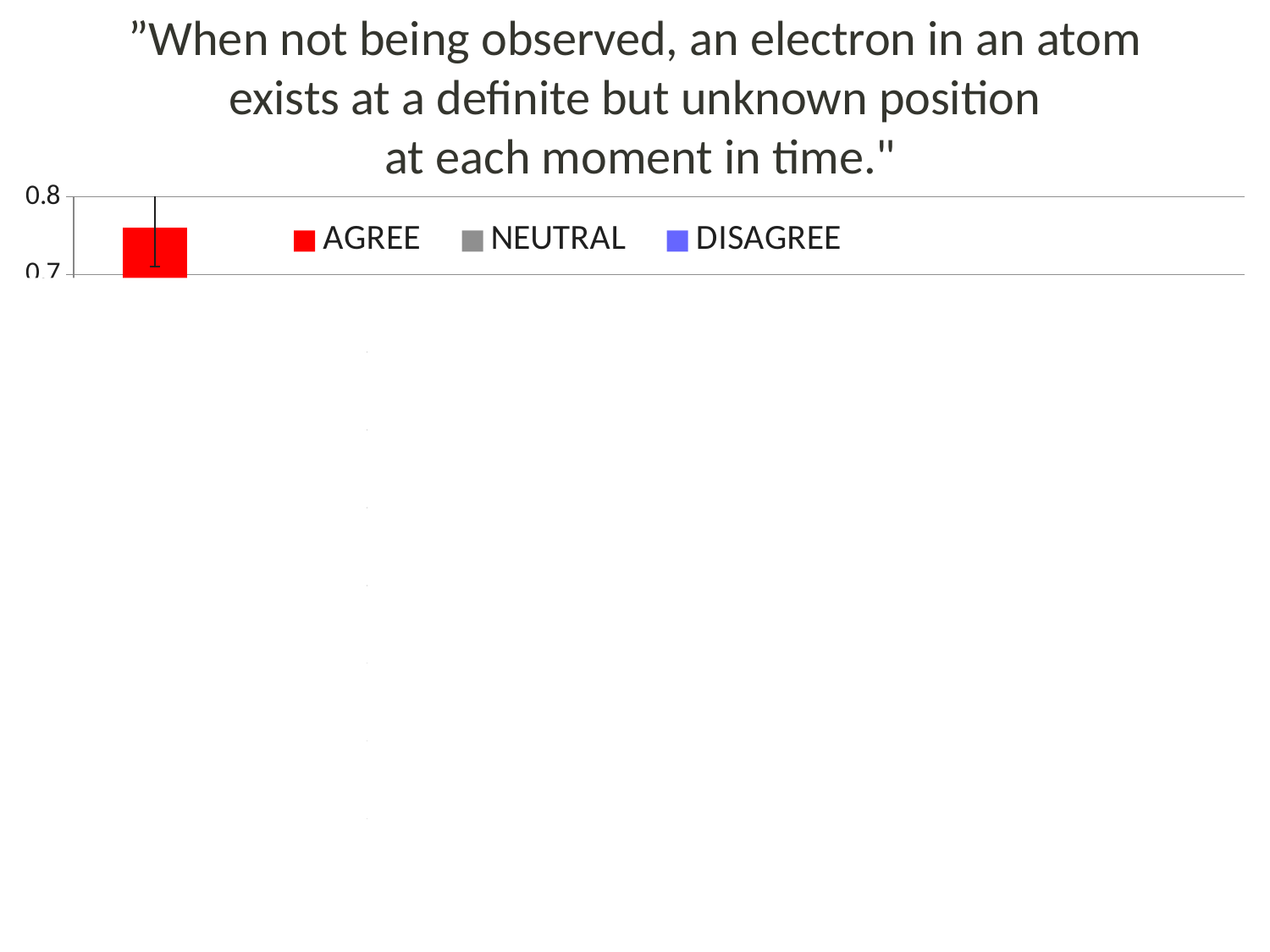
What kind of chart is shown on the slide? bar chart Which series is shown in red in the chart's legend? AGREE Which is larger, the value for AGREE or the value for NEUTRAL? AGREE Is the value for AGREE greater or less than 0.7? greater Which series has the highest value in the chart? AGREE What are the three entries in the chart's legend? AGREE, NEUTRAL, DISAGREE How many series does the chart's legend list? 3 Is the value for AGREE greater or less than 0.8? less